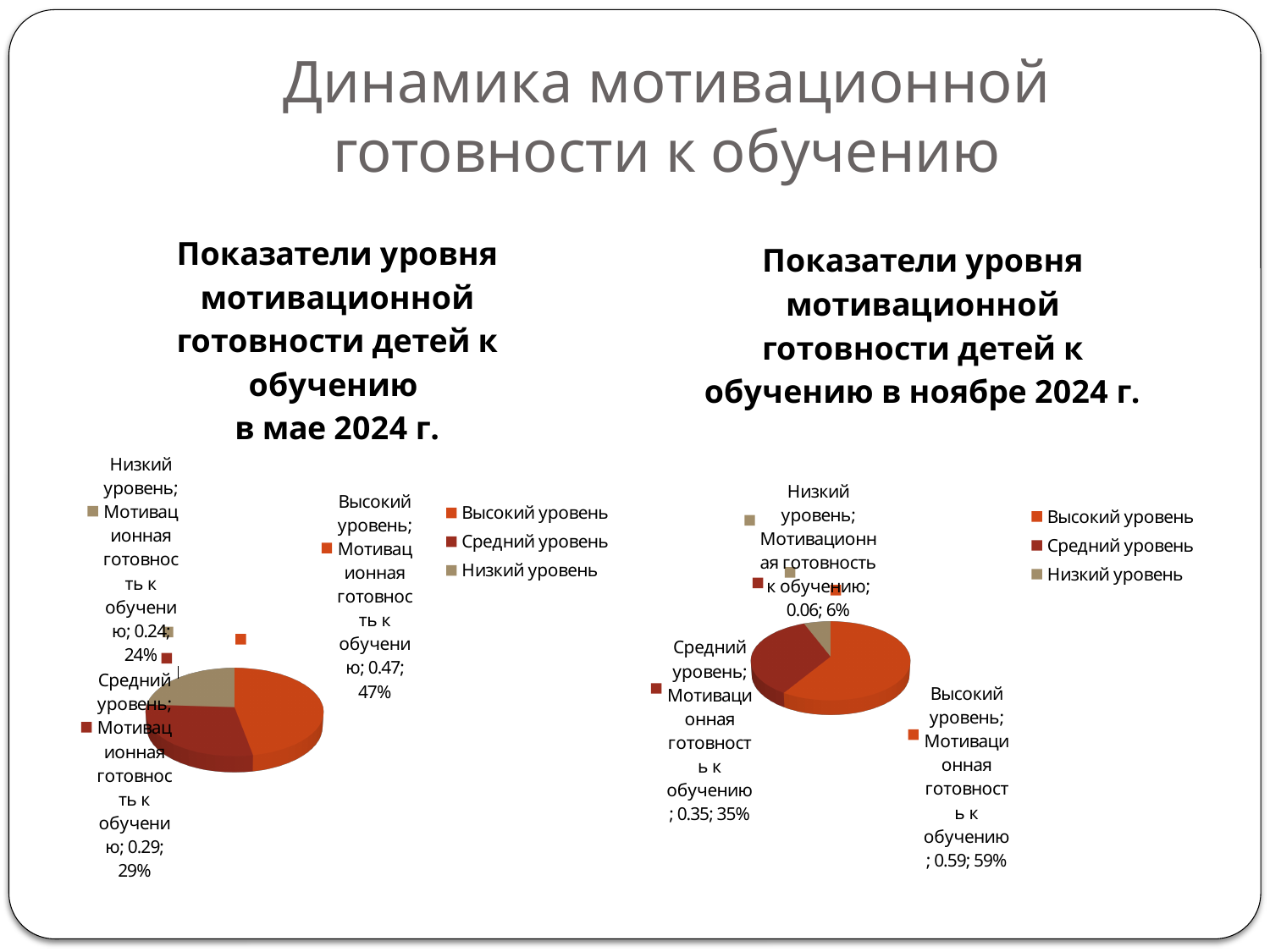
What type of chart is the left chart (May 2024)? Pie chart In the right chart (November 2024), which level has the largest slice? Высокий уровень In the left chart (May 2024), what percentage share is shown for Высокий уровень? 47% In the left chart (May 2024), what percentage share is shown for Низкий уровень? 24% In the right chart (November 2024), what percentage share is shown for Низкий уровень? 6% Which is larger: Средний уровень in the left chart (May 2024) or Средний уровень in the right chart (November 2024)? Right chart (November 2024) What is the difference in percentage points between Высокий уровень in the right chart (November 2024) and Высокий уровень in the left chart (May 2024)? 12 In the left chart (May 2024), which level has the smallest slice? Низкий уровень How many slices does the right chart (November 2024) have? 3 How many entries does the legend of the left chart (May 2024) list? 3 In the right chart (November 2024), what percentage share is shown for Средний уровень? 35% In the left chart (May 2024), what is the difference in percentage points between Средний уровень and Низкий уровень? 5